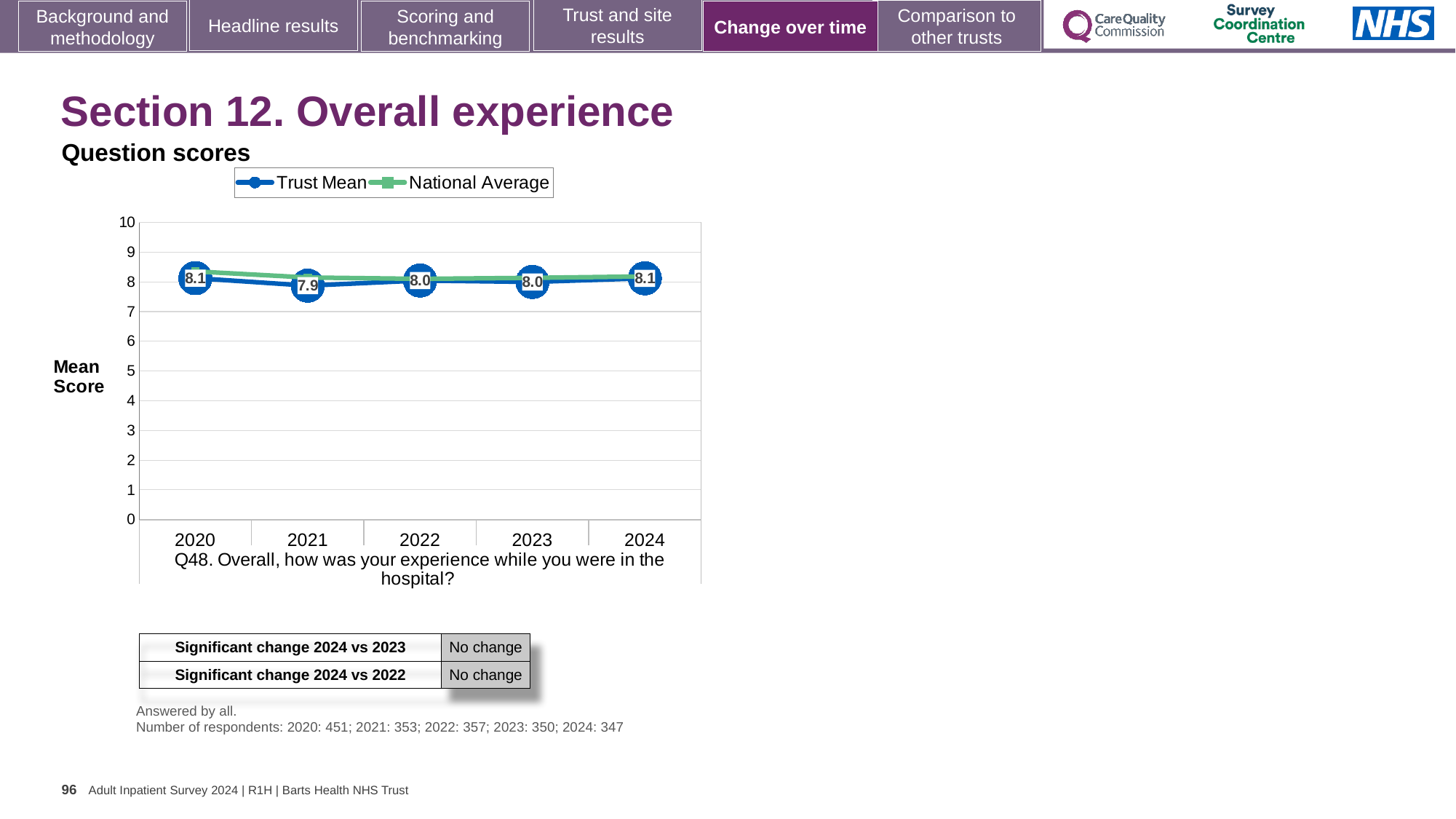
Is the National Average value for 2020 greater or less than 5? greater What is the Trust Mean score for 2020? 8.1 In which year is the Trust Mean score lowest? 2021 What is the Trust Mean score for 2021? 7.9 Which is larger, the Trust Mean score for 2021 or for 2022? 2022 How many years are shown on the x axis of the chart? 5 Does the Trust Mean score rise or fall from 2021 to 2024? Rise What is the Trust Mean score for 2024? 8.1 What is the difference between the Trust Mean score in 2024 and in 2021? 0.2 What kind of chart is shown on the slide? Line chart What is the Trust Mean score for 2023? 8.0 How many series does the chart legend list? 2